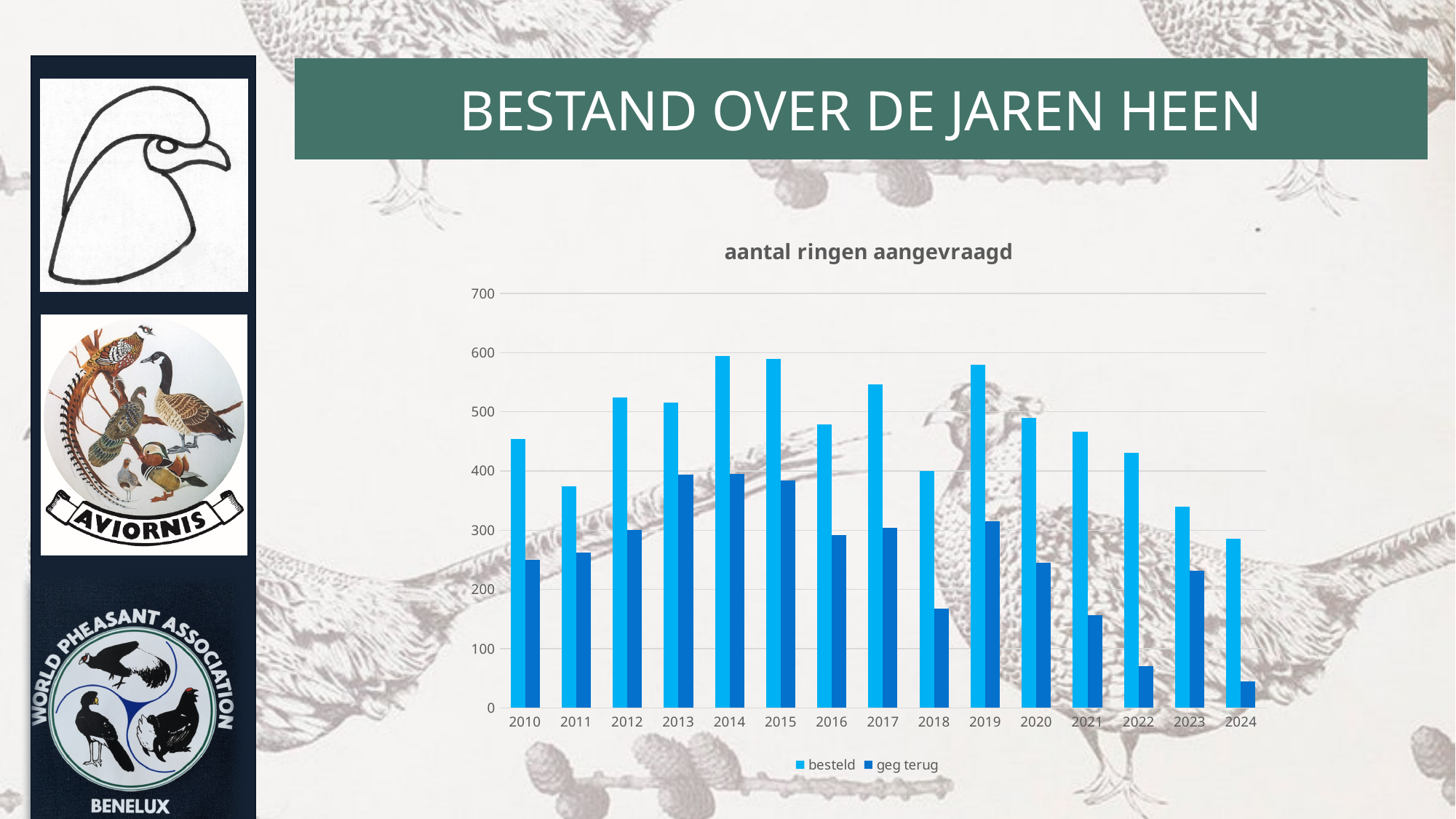
Which year has the lowest value for 'geg terug'? 2024 How many series does the legend list? 2 Is the 'geg terug' value for 2013 greater or less than 300? greater Is the 'besteld' value for 2014 greater or less than 500? greater Which year has the larger 'besteld' value, 2012 or 2018? 2012 What kind of chart is shown on the slide? bar chart How many years are shown on the x axis of the chart? 15 Is the 'geg terug' value for 2022 greater or less than 100? less Do the 'besteld' values rise or fall from 2019 to 2024? fall Which year has the lowest value for 'besteld'? 2024 What is the title of the chart? aantal ringen aangevraagd